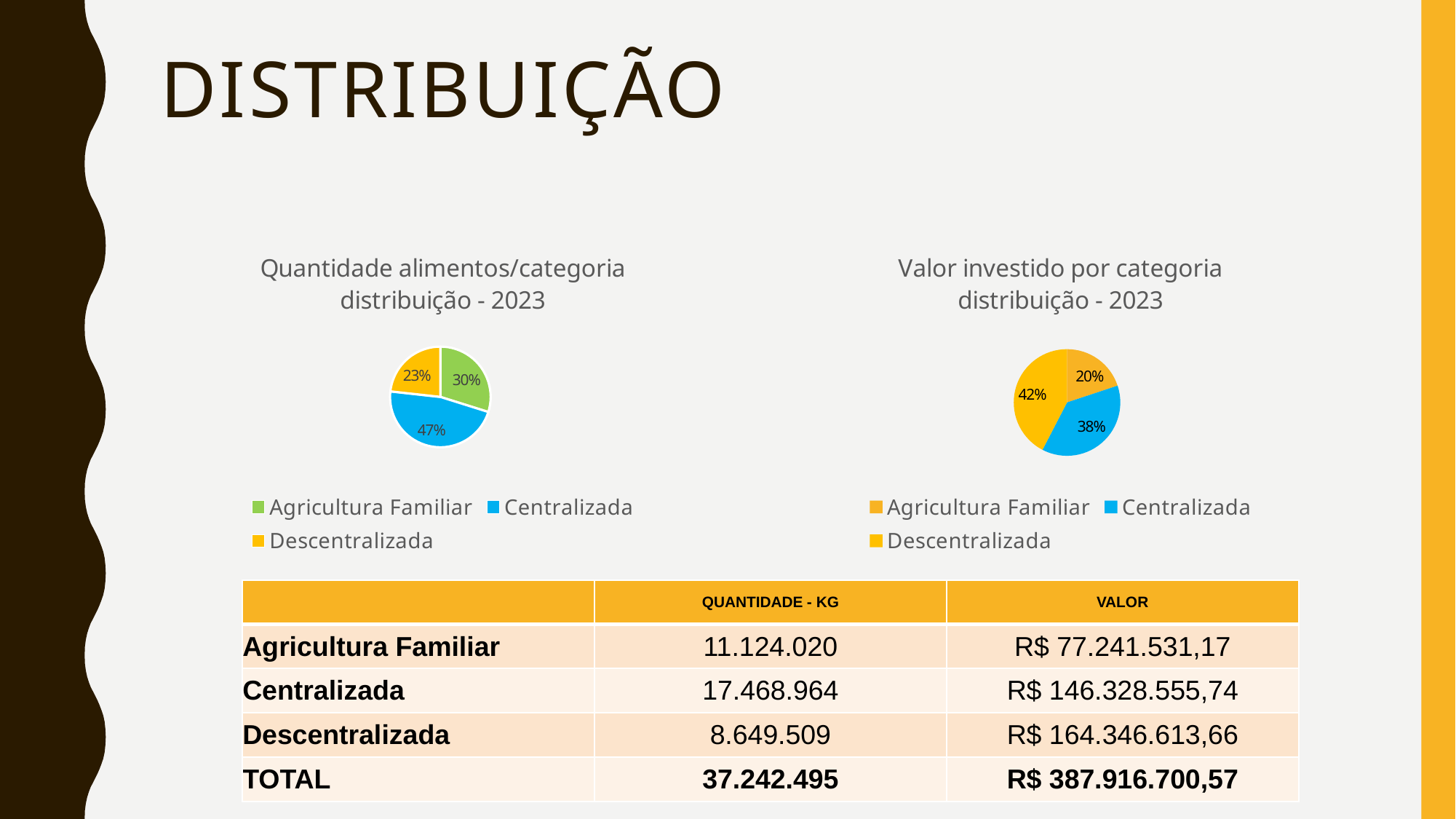
In the chart titled "Valor investido por categoria distribuição - 2023", what share does Agricultura Familiar have? 20% In the chart titled "Quantidade alimentos/categoria distribuição - 2023", what share does Descentralizada have? 23% In the chart titled "Quantidade alimentos/categoria distribuição - 2023", what share does Agricultura Familiar have? 30% In the chart titled "Quantidade alimentos/categoria distribuição - 2023", what is the difference in percentage points between Centralizada and Descentralizada? 24 percentage points What type of chart is the one on the left, titled "Quantidade alimentos/categoria distribuição - 2023"? Pie chart In the chart titled "Valor investido por categoria distribuição - 2023", which category has the smallest slice? Agricultura Familiar How many categories does the legend of the chart titled "Valor investido por categoria distribuição - 2023" list? 3 In the chart titled "Valor investido por categoria distribuição - 2023", which is larger, Descentralizada or Centralizada? Descentralizada In the chart titled "Quantidade alimentos/categoria distribuição - 2023", which category has the largest slice? Centralizada